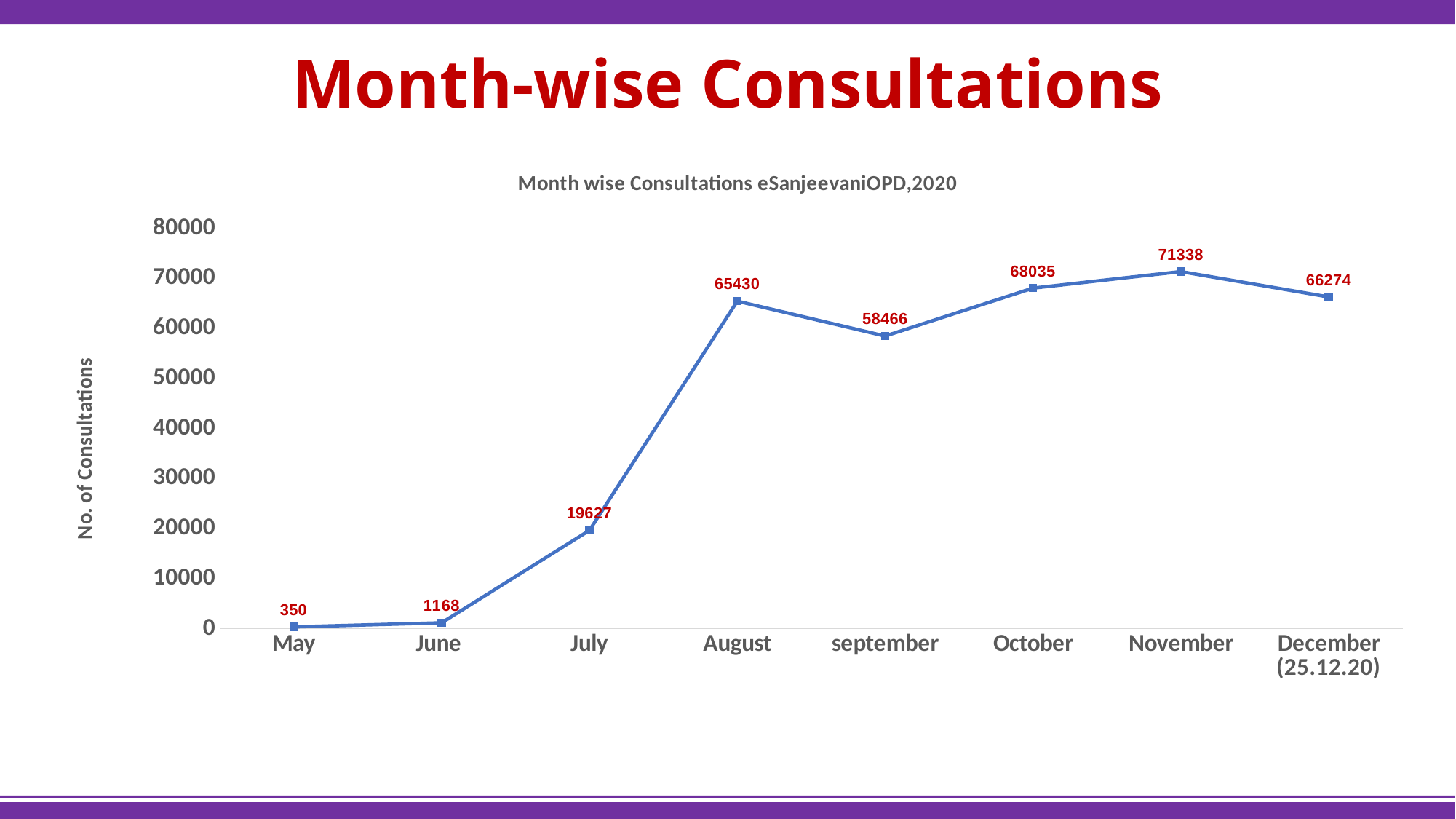
What is the difference in consultations between November and December (25.12.20)? 5064 What is the number of consultations for August? 65430 What is the title of the chart? Month wise Consultations eSanjeevaniOPD,2020 Which month has the lowest number of consultations? May What is the difference in consultations between August and July? 45803 How many months are plotted on the chart? 8 What is the number of consultations for October? 68035 What is the number of consultations for May? 350 Which month has the highest number of consultations? November What kind of chart is shown on the slide? Line chart Which month has more consultations, September or October? October Is the value for July greater or less than 20000? less